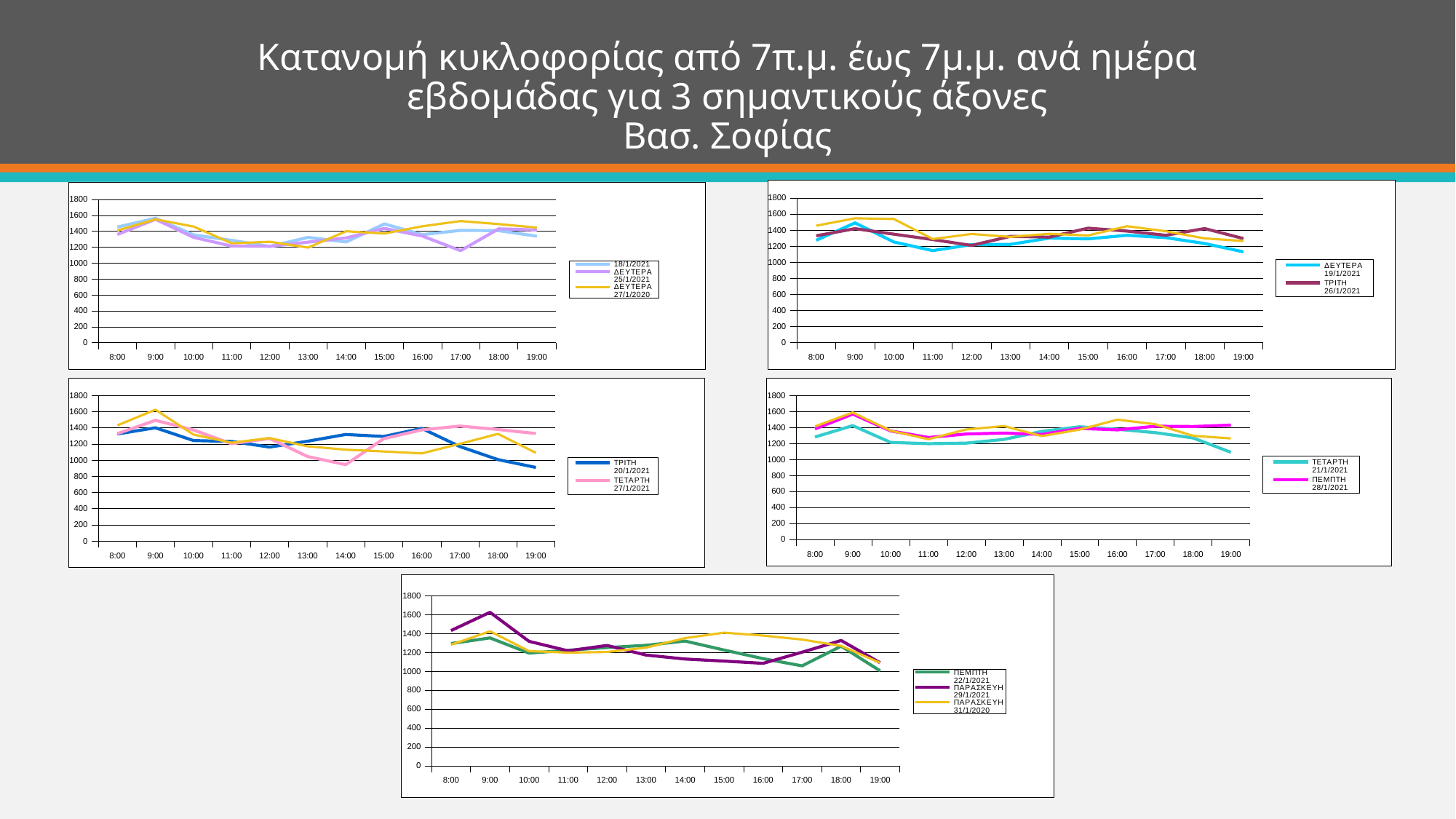
How many series does the legend of the middle-right chart list? 2 In the bottom chart, is the value for ΠΑΡΑΣΚΕΥΗ 29/1/2021 at 9:00 greater or less than 1600? greater How many time points are plotted along the x axis of the bottom chart? 12 In the middle-left chart, does the ΤΡΙΤΗ 20/1/2021 line rise or fall from 16:00 to 19:00? fall In the bottom chart, at which time does ΠΑΡΑΣΚΕΥΗ 29/1/2021 reach its highest value? 9:00 In the middle-left chart, at which time does ΤΡΙΤΗ 20/1/2021 reach its lowest value? 19:00 What kind of chart is the top-left chart on the slide? line chart How many series does the legend of the top-left chart list? 3 In the middle-left chart, which series has the larger value at 9:00, ΤΡΙΤΗ 20/1/2021 or ΤΕΤΑΡΤΗ 27/1/2021? ΤΕΤΑΡΤΗ 27/1/2021 In the middle-left chart, is the value for ΤΡΙΤΗ 20/1/2021 at 19:00 greater or less than 1000? less In the middle-left chart, is the value for ΤΕΤΑΡΤΗ 27/1/2021 at 14:00 greater or less than 1000? less